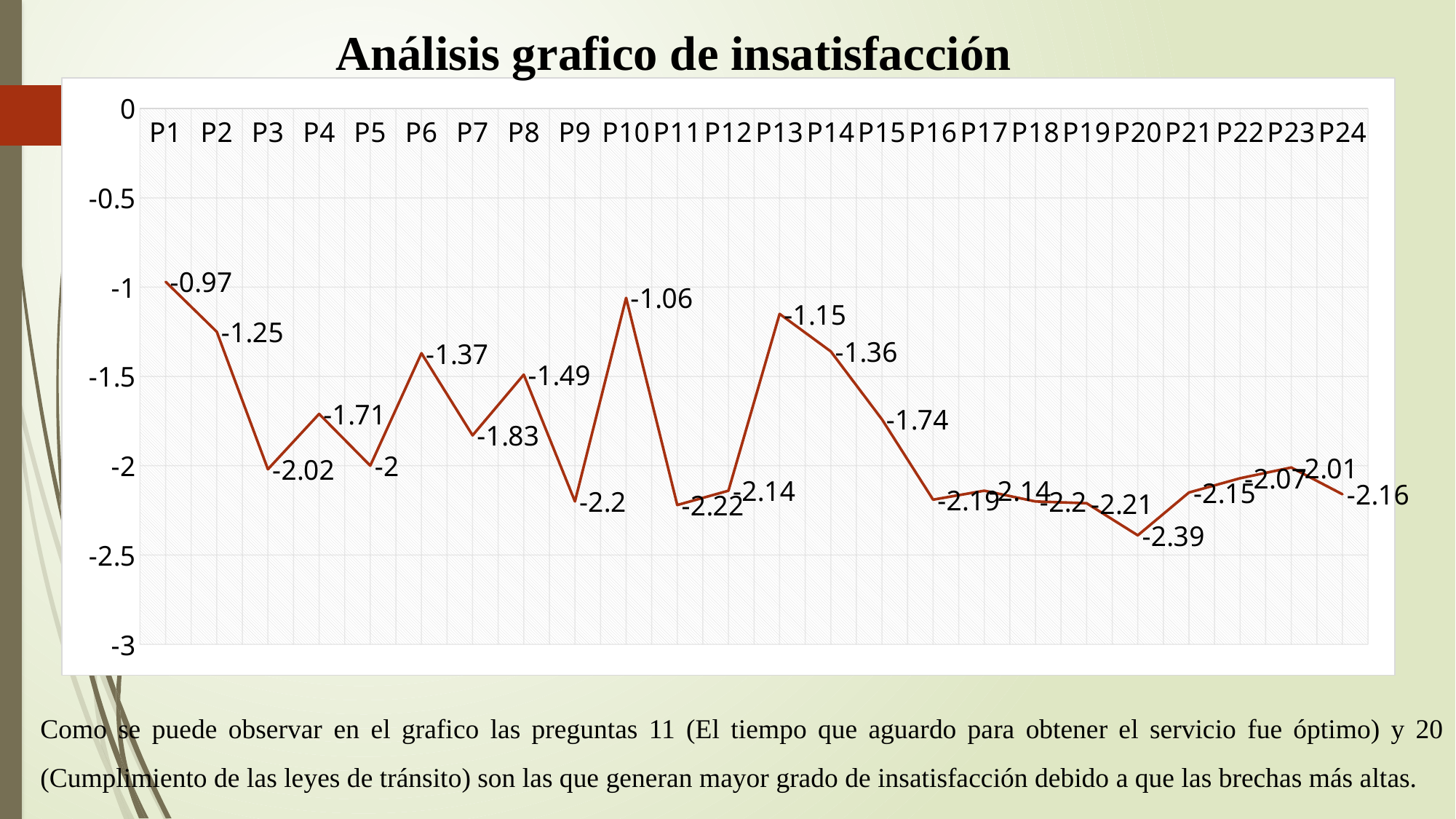
What kind of chart is shown on the slide? Line chart What is the value for P13? -1.15 How many categories are plotted on the chart? 24 Which category has the lowest value? P20 What is the value for P1? -0.97 What is the value for P10? -1.06 What is the value for P20? -2.39 Which category has the highest value? P1 What is the title of the slide? Análisis grafico de insatisfacción Which has a larger value, P6 or P7? P6 Is the value for P15 greater or less than -2? greater What is the difference between the values for P1 and P20? 1.42